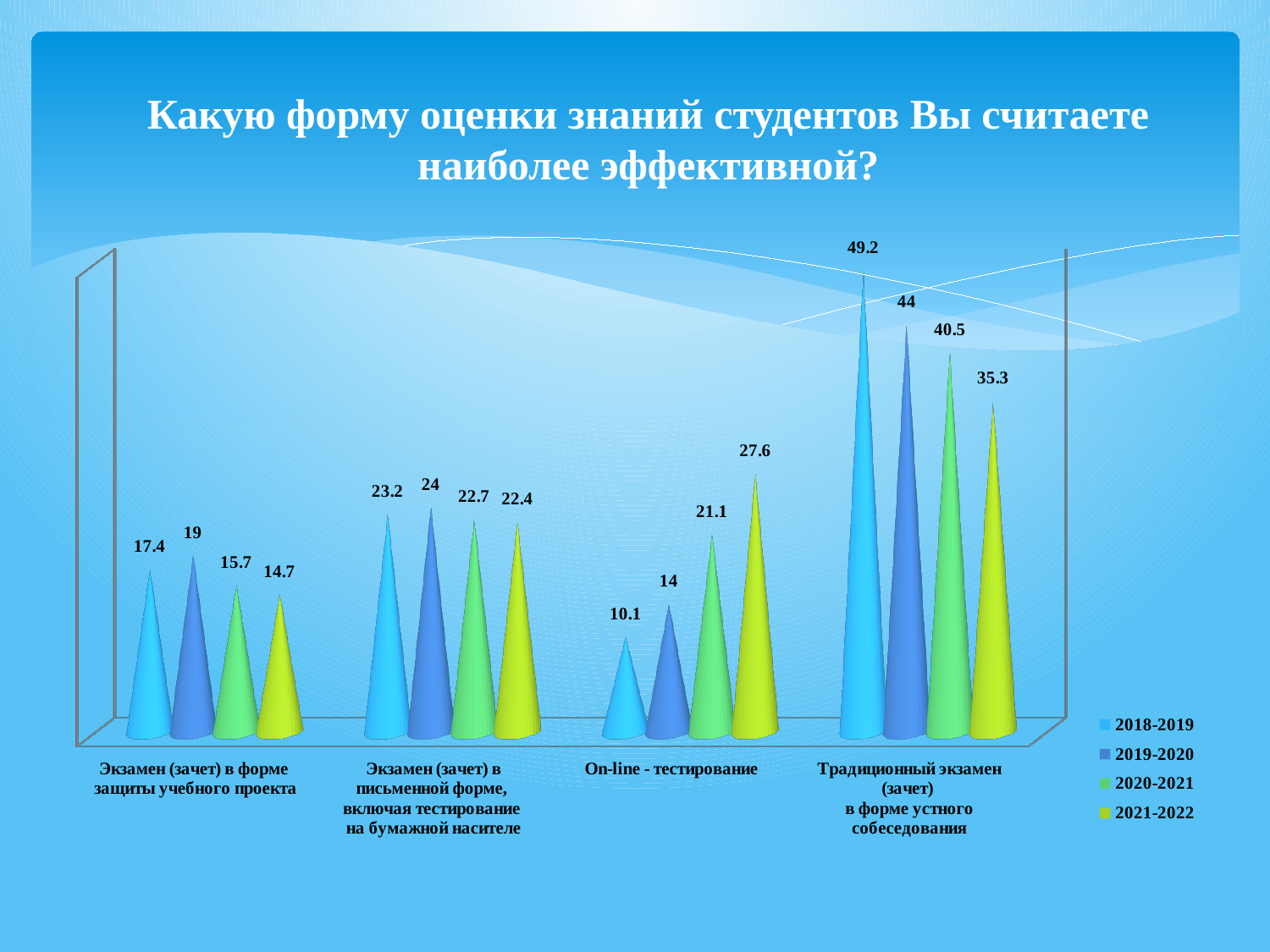
Which category has the highest value for the 2018-2019 series? Традиционный экзамен (зачет) в форме устного собеседования What is the value for 2021-2022 in the category "On-line - тестирование"? 27.6 What is the value for 2020-2021 in the category "Экзамен (зачет) в письменной форме, включая тестирование на бумажной насителе"? 22.7 What is the value for 2018-2019 in the category "Традиционный экзамен (зачет) в форме устного собеседования"? 49.2 What is the value for 2019-2020 in the category "Экзамен (зачет) в форме защиты учебного проекта"? 19 Which is larger for "On-line - тестирование": the 2018-2019 value or the 2021-2022 value? 2021-2022 What is the difference between the 2018-2019 and 2021-2022 values for "Традиционный экзамен (зачет) в форме устного собеседования"? 13.9 How many categories are shown on the x axis of the chart? 4 What kind of chart is shown on the slide? Bar chart For "On-line - тестирование", do the values rise or fall from 2018-2019 to 2021-2022? Rise How many series does the legend list? 4 Which category has the lowest value for the 2018-2019 series? On-line - тестирование